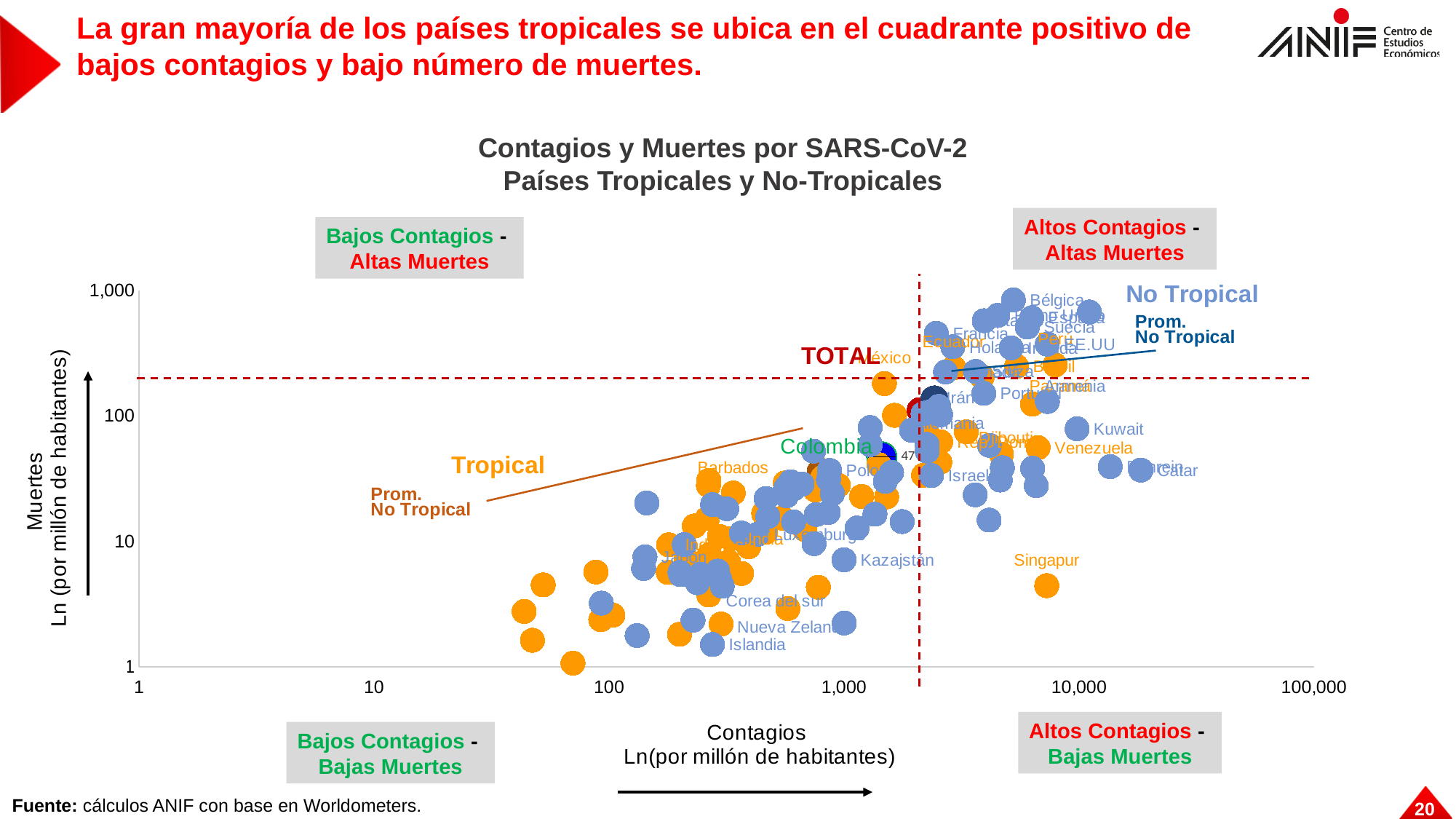
Which country has the higher deaths value (Muertes), Bélgica or Singapur? Bélgica What colour are the points for tropical countries in the chart? orange Is the contagios value for Corea del sur greater or less than 1,000? less Is the contagios value for Catar greater or less than 10,000? greater Is the deaths value (Muertes) for Bélgica greater or less than 100? greater Do deaths per million generally rise or fall as contagios per million increase along the x axis? rise What is the title of the chart? Contagios y Muertes por SARS-CoV-2 Países Tropicales y No-Tropicales Which country has the higher contagios value, Catar or Islandia? Catar What kind of chart is shown on the slide? scatter chart